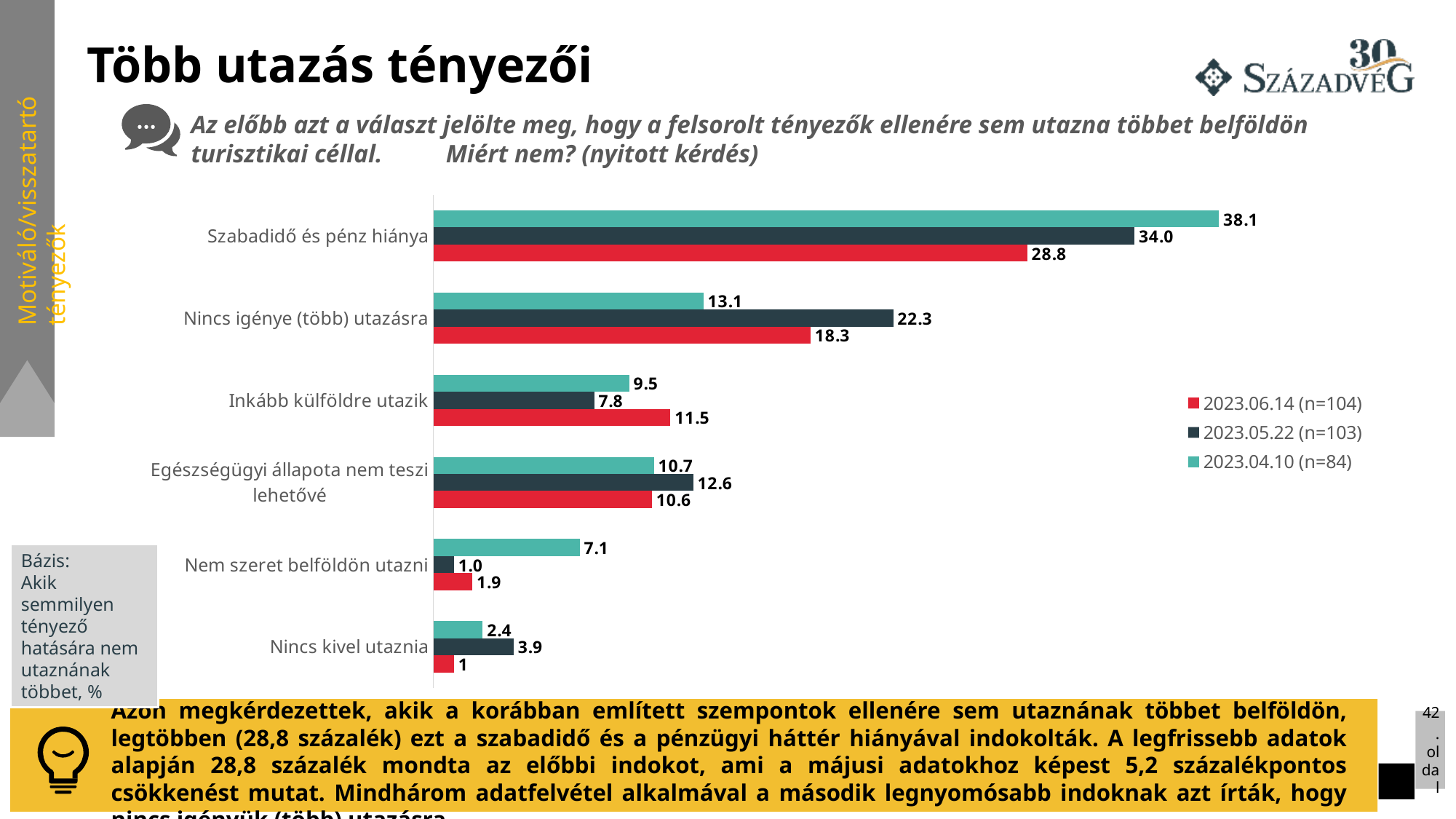
What kind of chart is shown on the slide? bar chart What is the value for "Nincs igénye (több) utazásra" in the 2023.05.22 (n=103) series? 22.3 Which category has the highest value in the 2023.04.10 (n=84) series? Szabadidő és pénz hiánya What is the value for "Nem szeret belföldön utazni" in the 2023.04.10 (n=84) series? 7.1 How many categories are shown on the chart? 6 What is the difference between the 2023.05.22 (n=103) and 2023.06.14 (n=104) values for "Szabadidő és pénz hiánya"? 5.2 What is the value for "Szabadidő és pénz hiánya" in the 2023.06.14 (n=104) series? 28.8 What is the difference between the 2023.05.22 (n=103) and 2023.04.10 (n=84) values for "Nincs igénye (több) utazásra"? 9.2 Which colour represents the 2023.06.14 (n=104) series in the legend? red How many series does the legend list? 3 For "Inkább külföldre utazik", which series has the larger value: 2023.06.14 (n=104) or 2023.05.22 (n=103)? 2023.06.14 (n=104) Which category has the lowest value in the 2023.06.14 (n=104) series? Nincs kivel utaznia